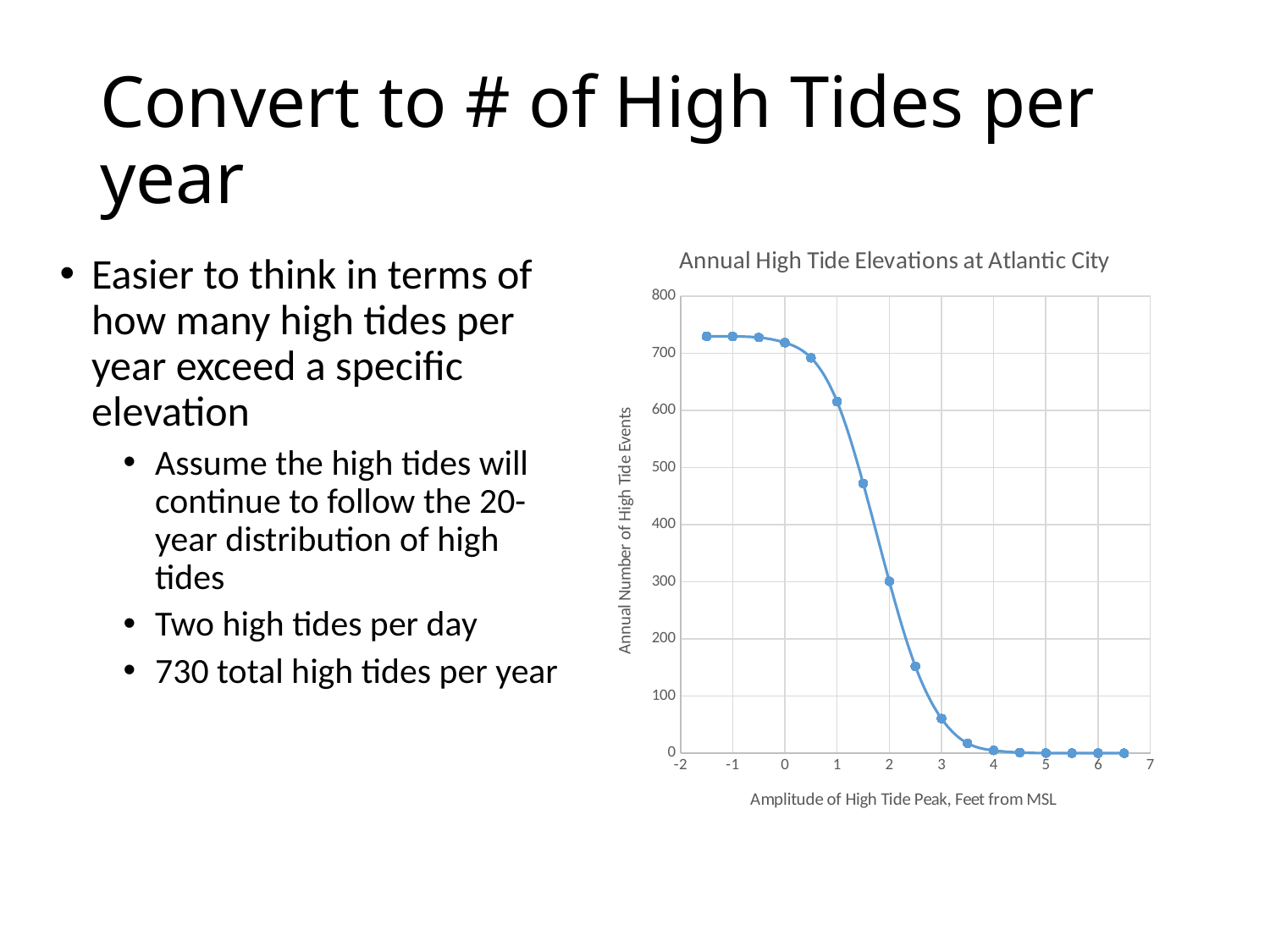
Is the value at an amplitude of 2.5 feet greater or less than 100? greater Which has the larger value: an amplitude of 3 feet or an amplitude of 2.5 feet? 2.5 feet What is the title of the chart? Annual High Tide Elevations at Atlantic City Is the value at an amplitude of 0 feet greater or less than 700? greater Which has the larger value: an amplitude of 1 foot or an amplitude of 2 feet? 1 foot Do the values rise or fall as the amplitude increases along the x axis? fall Is the value at an amplitude of 1.5 feet greater or less than 500? less How many data points are plotted on the chart? 17 What kind of chart is shown on the slide? line chart What is the label of the x axis of the chart? Amplitude of High Tide Peak, Feet from MSL